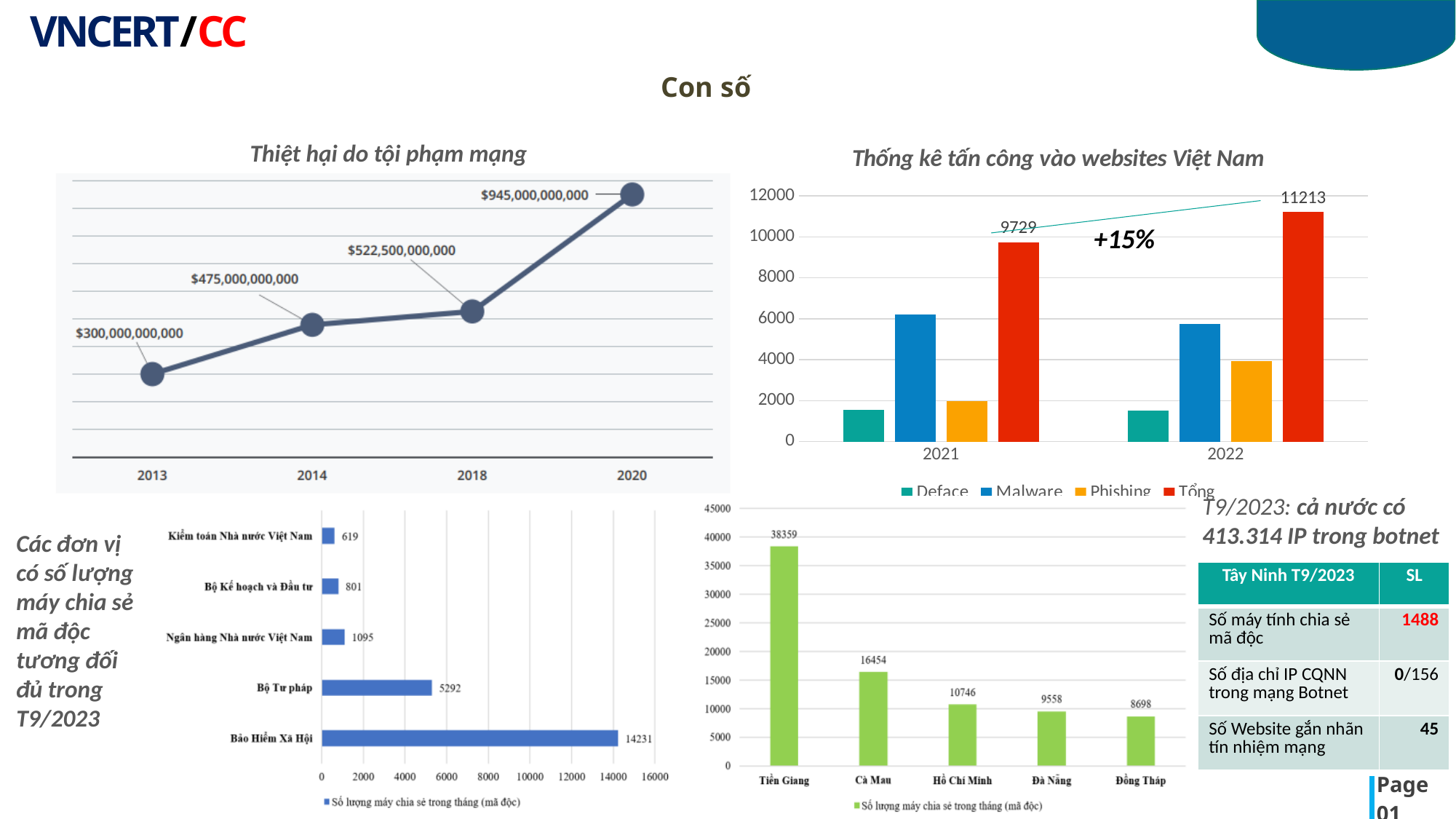
In the 'Thống kê tấn công vào websites Việt Nam' chart, how many series does the legend list? 4 In the green bar chart at the bottom middle, which province has the highest value? Tiền Giang In the 'Thiệt hại do tội phạm mạng' chart at the top left, what is the value for 2020? $945,000,000,000 In the 'Thống kê tấn công vào websites Việt Nam' chart, which is larger for 2022: Phishing or Malware? Malware In the horizontal bar chart at the bottom left, which unit has the lowest value? Kiểm toán Nhà nước Việt Nam In the 'Thiệt hại do tội phạm mạng' chart at the top left, what is the difference between the 2014 and 2013 values? $175,000,000,000 In the green bar chart at the bottom middle, what is the difference between Cà Mau and Hồ Chí Minh? 5708 In the 'Thống kê tấn công vào websites Việt Nam' chart, is the Malware value for 2021 greater or less than 4000? greater In the 'Thiệt hại do tội phạm mạng' chart at the top left, what kind of chart is shown? line chart In the 'Thống kê tấn công vào websites Việt Nam' chart, what is the value of Tổng for 2022? 11213 In the 'Thiệt hại do tội phạm mạng' chart at the top left, do the values rise or fall from 2013 to 2020? rise In the horizontal bar chart at the bottom left, what is the value for Bộ Tư pháp? 5292